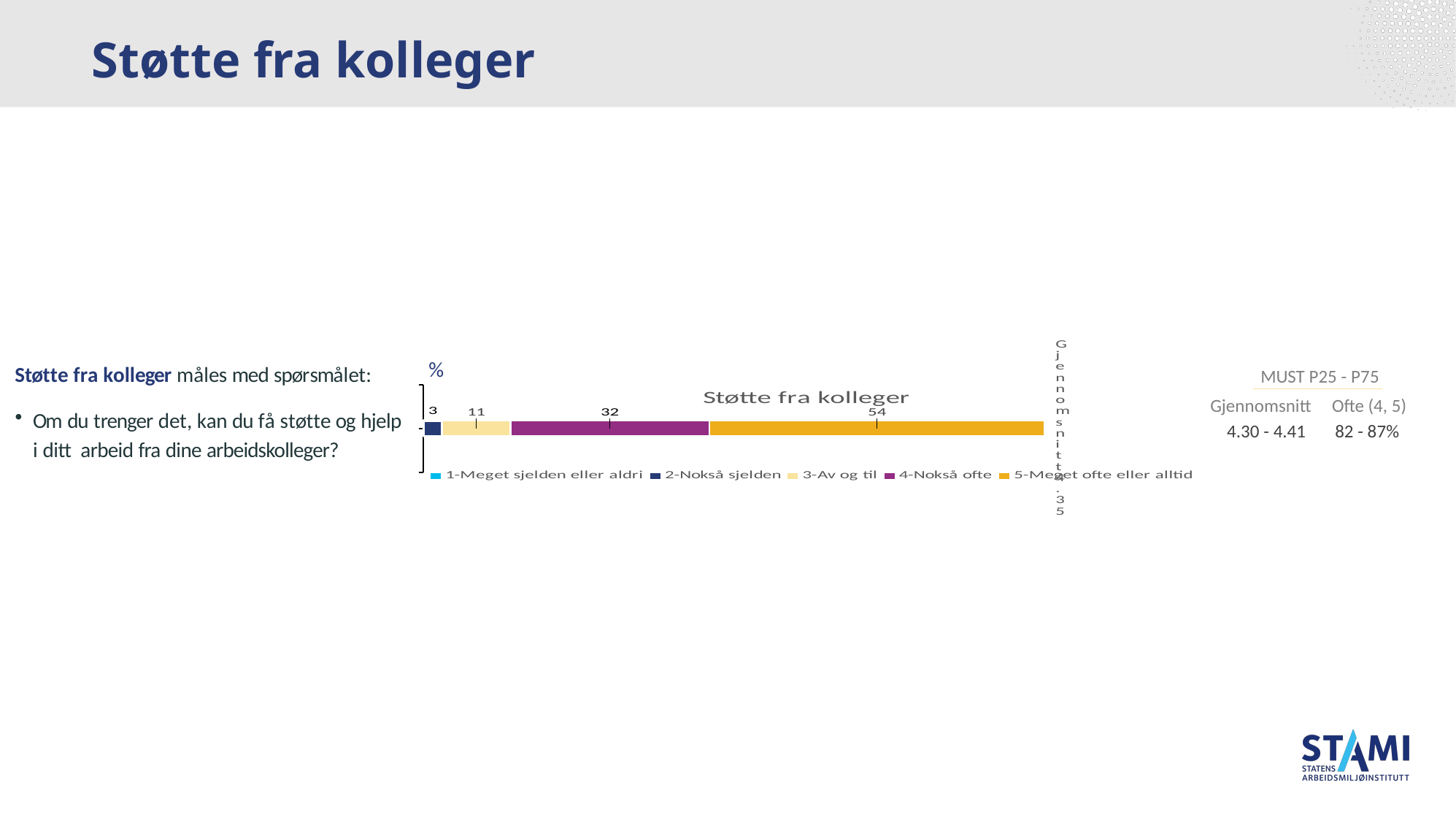
What is the difference between the values for 4-Nokså ofte and 3-Av og til? 21 What is the difference between the values for 5-Meget ofte eller alltid and 4-Nokså ofte? 22 What is the value for 5-Meget ofte eller alltid in the chart? 54 What is the value for 4-Nokså ofte in the chart? 32 How many series does the legend of the chart list? 5 What is the value for 2-Nokså sjelden in the chart? 3 Which is larger, the value for 3-Av og til or the value for 4-Nokså ofte? 4-Nokså ofte Which series has the highest value in the chart? 5-Meget ofte eller alltid What is the total of the labelled segments in the stacked bar? 100 What is the title of the chart? Støtte fra kolleger What is the value for 3-Av og til in the chart? 11 What kind of chart is shown on the slide? bar chart